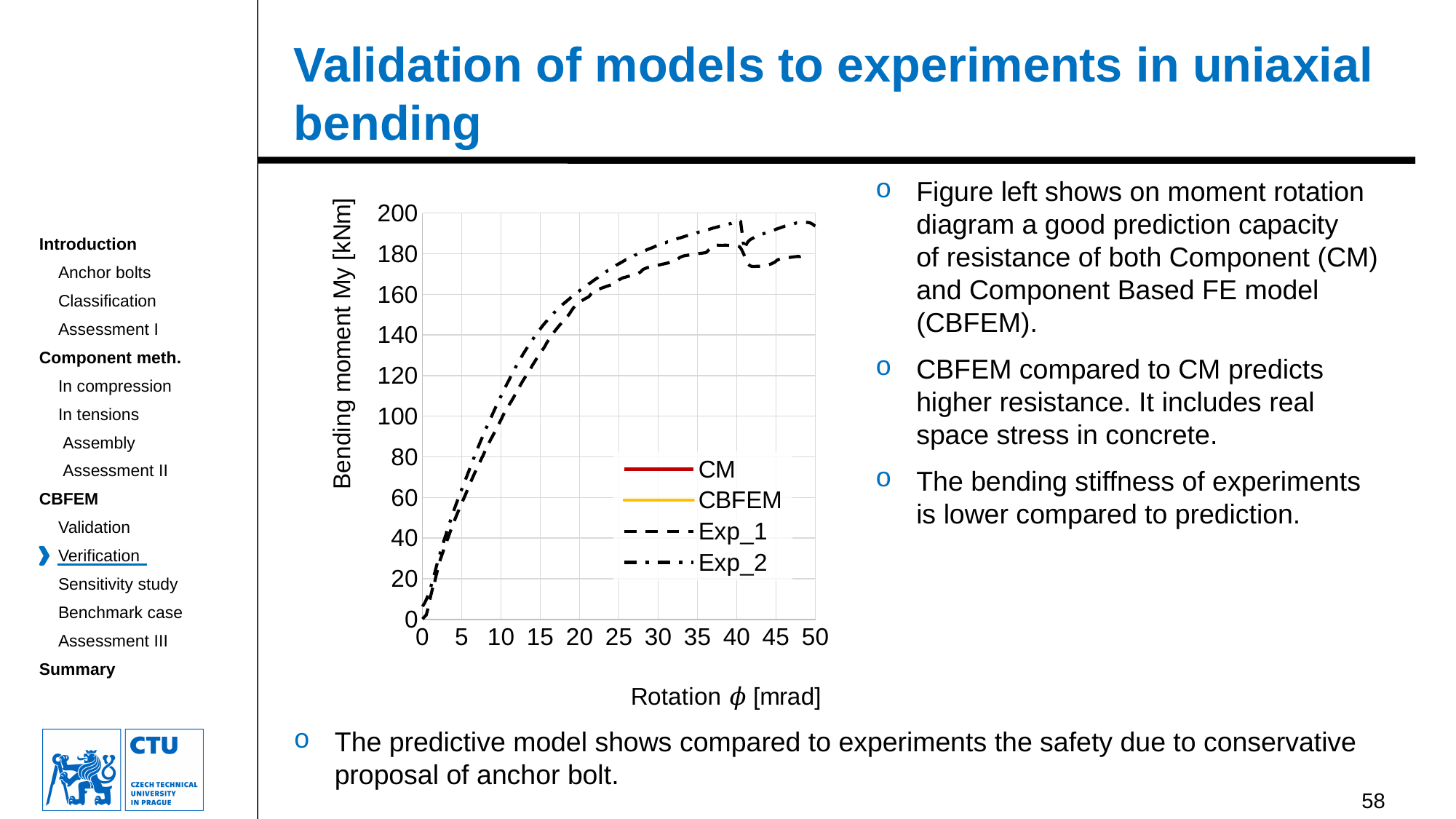
Does the bending moment of Exp_2 rise or fall as rotation increases from 0 to 35 mrad? rise What is the label of the vertical axis of the chart? Bending moment My [kNm] Is the value of Exp_2 at a rotation of 15 mrad greater or less than 120 kNm? greater Is the value of Exp_1 at a rotation of 30 mrad greater or less than 160 kNm? greater What is the label of the horizontal axis of the chart? Rotation ϕ [mrad] How many series does the chart legend list? 4 Is the value of Exp_2 at a rotation of 40 mrad greater or less than 180 kNm? greater Which series reaches the highest bending moment on the chart, Exp_1 or Exp_2? Exp_2 At a rotation of 30 mrad, which series has the higher bending moment, Exp_1 or Exp_2? Exp_2 What kind of chart is shown on the slide? line chart